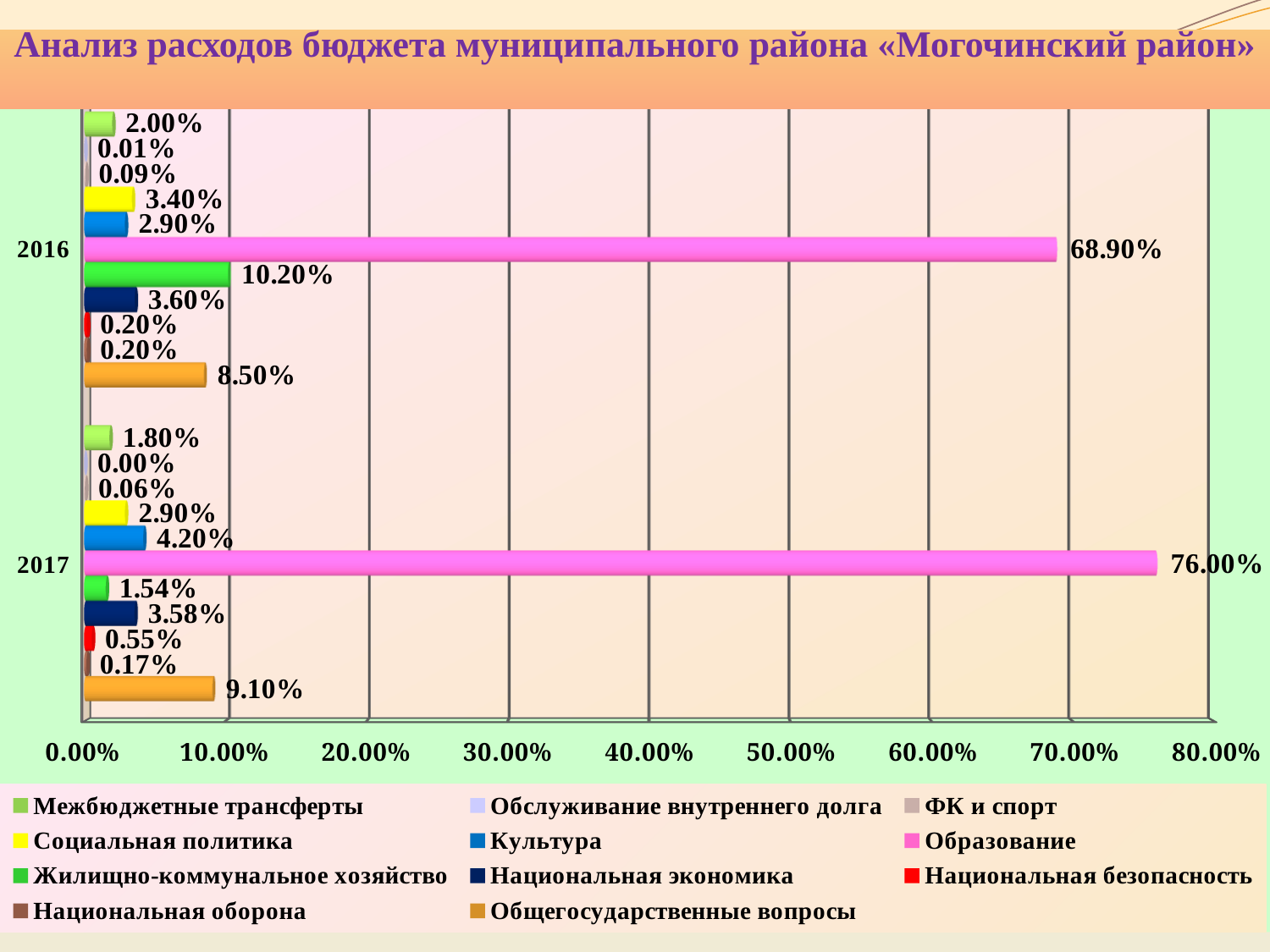
Which series has the highest value in 2017? Образование Is the value for Образование in 2016 greater or less than 70.00%? less Which is larger: Культура in 2016 or Культура in 2017? Культура in 2017 What kind of chart is shown on the slide? bar chart What is the value for Жилищно-коммунальное хозяйство in 2016? 10.20% What is the value for Общегосударственные вопросы in 2017? 9.10% How many series does the legend list? 11 What is the value for Образование in 2016? 68.90% Which series has the lowest value in 2017? Обслуживание внутреннего долга How many years (categories) are shown on the chart? 2 What is the difference between the Образование values for 2017 and 2016? 7.10% What is the value for Образование in 2017? 76.00%